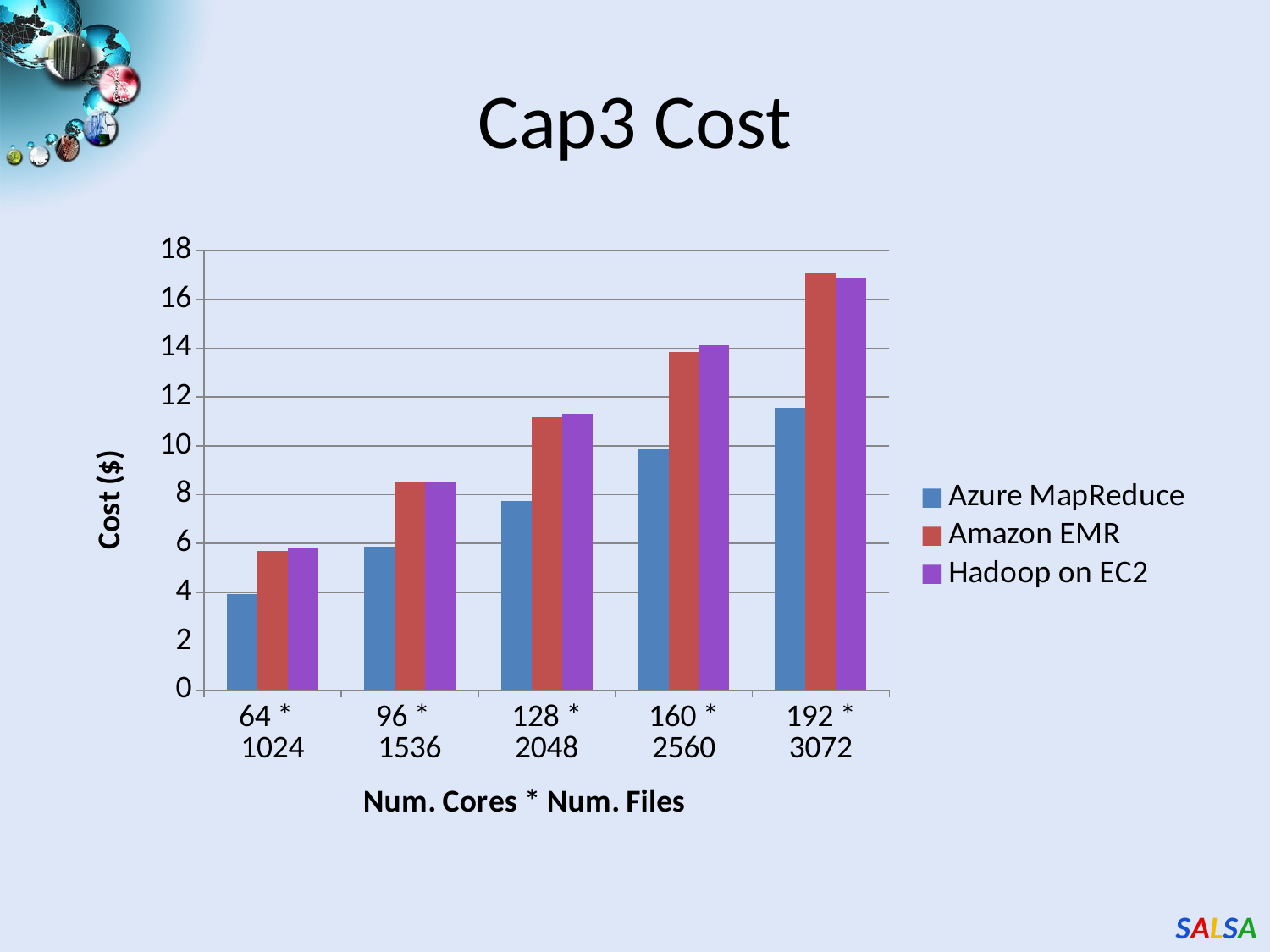
Do the Hadoop on EC2 costs rise or fall as the number of cores and files increases along the x axis? rise Which series has the lowest cost at 192 * 3072? Azure MapReduce How many categories are shown on the x axis? 5 What kind of chart is shown on the slide? bar chart For which category is the Azure MapReduce cost highest? 192 * 3072 For which category is the Amazon EMR cost lowest? 64 * 1024 What is the title of the chart? Cap3 Cost Is the Azure MapReduce cost at 192 * 3072 greater or less than 10? greater What is the label of the y axis? Cost ($) Is the Amazon EMR cost at 192 * 3072 greater or less than 16? greater At 160 * 2560, which is larger: the Azure MapReduce cost or the Amazon EMR cost? Amazon EMR How many series does the legend list? 3